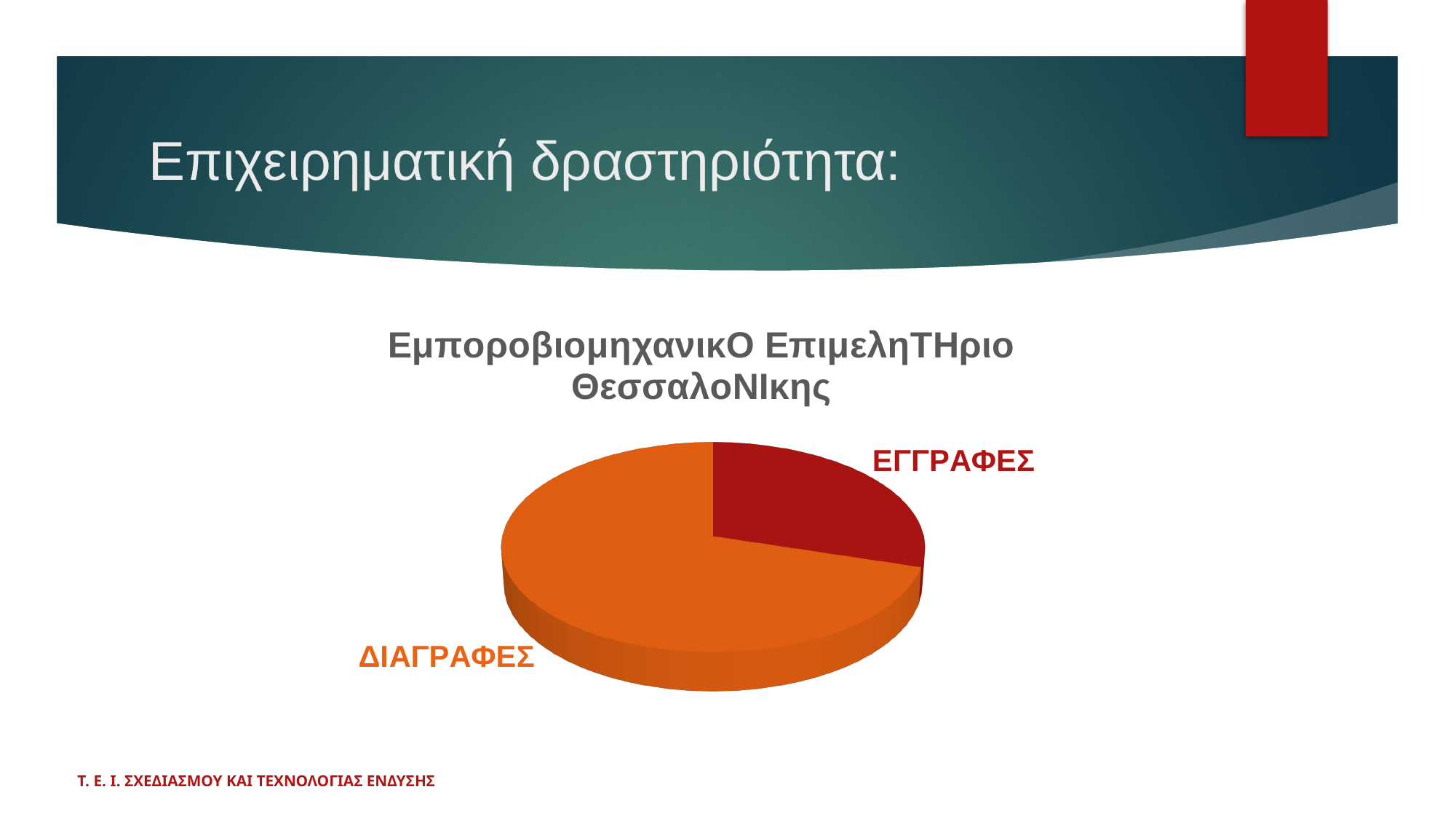
What colour is the ΕΓΓΡΑΦΕΣ slice of the pie chart? red How many slices does the pie chart have? 2 What kind of chart is shown on the slide? pie chart Which category has the largest slice of the pie chart? ΔΙΑΓΡΑΦΕΣ What is the title of the pie chart? ΕμποροβιομηχανικΟ ΕπιμεληΤΗριο ΘεσσαλοΝΙκης Which slice is larger, ΕΓΓΡΑΦΕΣ or ΔΙΑΓΡΑΦΕΣ? ΔΙΑΓΡΑΦΕΣ Which category has the smallest slice of the pie chart? ΕΓΓΡΑΦΕΣ